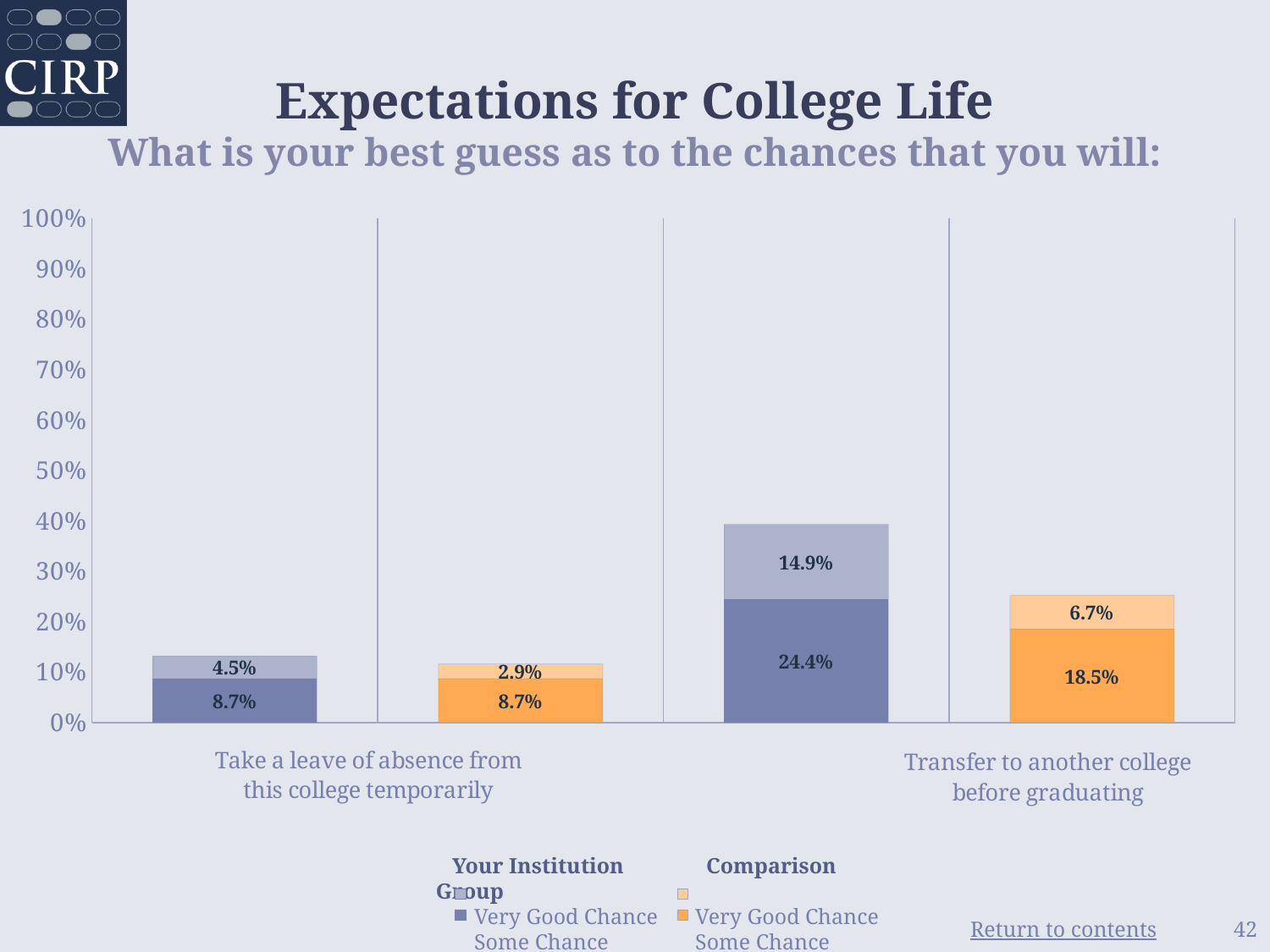
Which is larger for 'Take a leave of absence from this college temporarily': the 'Some Chance' value for Your Institution or for the Comparison Group? They are equal (both 8.7%) How many categories are shown on the x axis of the chart? 2 What is the 'Very Good Chance' value for Your Institution for 'Transfer to another college before graduating'? 14.9% What is the difference between the 'Very Good Chance' values for Your Institution and the Comparison Group for 'Transfer to another college before graduating'? 8.2% What is the 'Some Chance' value for the Comparison Group for 'Take a leave of absence from this college temporarily'? 8.7% What is the total of the stacked bar for Your Institution for 'Transfer to another college before graduating'? 39.3% Which category has the highest 'Very Good Chance' value for Your Institution? Transfer to another college before graduating What is the 'Very Good Chance' value for the Comparison Group for 'Transfer to another college before graduating'? 6.7% What is the 'Some Chance' value for Your Institution for 'Transfer to another college before graduating'? 24.4% What kind of chart is shown on the slide? Stacked bar chart What is the total of the stacked bar for the Comparison Group for 'Take a leave of absence from this college temporarily'? 11.6% Is the total stacked bar for Your Institution for 'Transfer to another college before graduating' greater or less than 30%? greater